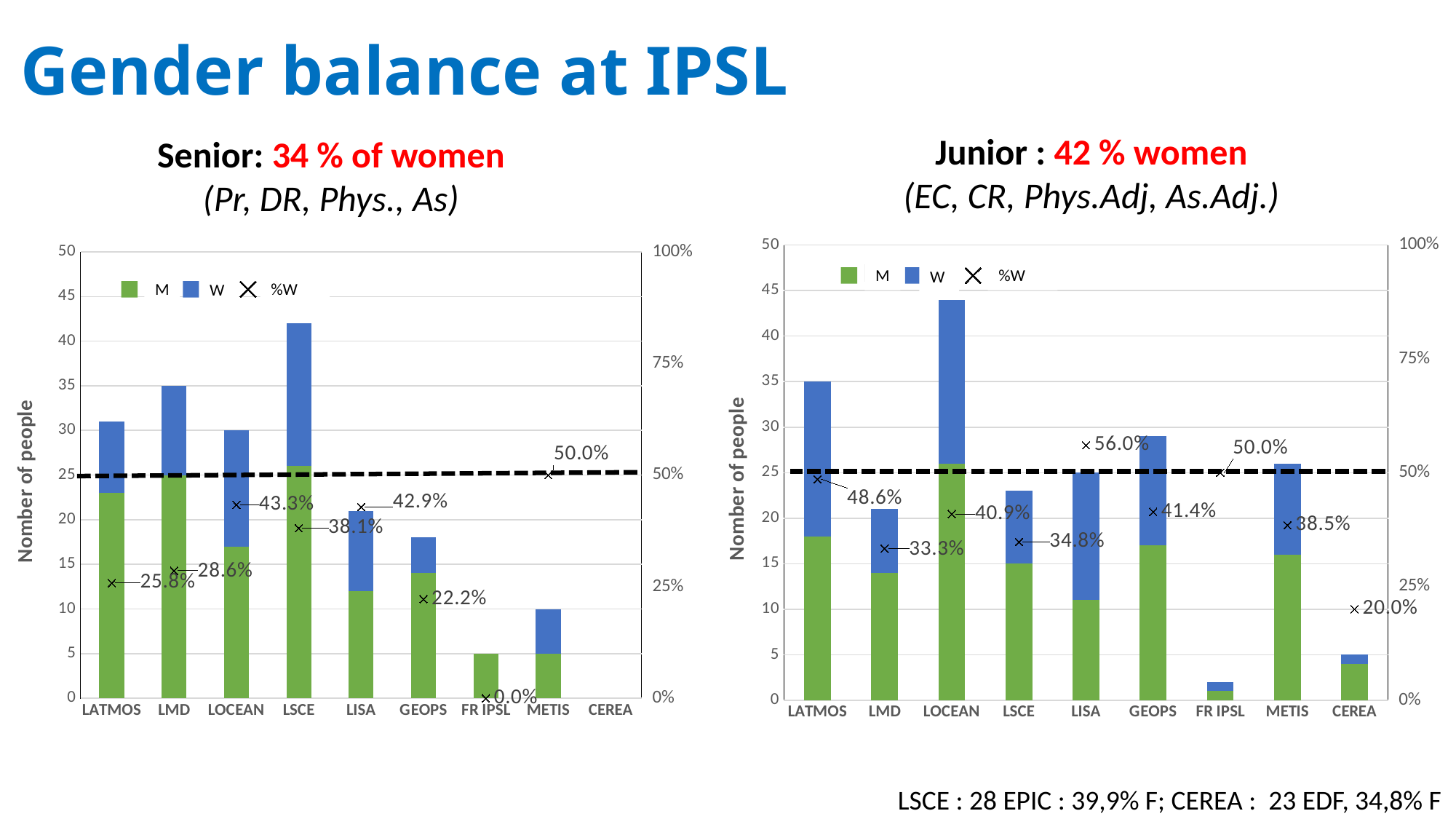
In the Junior chart, which has a higher %W value, LATMOS or LMD? LATMOS In the Junior chart, is the total number of people for LOCEAN greater or less than 40? greater In the Junior chart, what is the %W value for CEREA? 20.0% In the Junior chart, what is the %W value for LISA? 56.0% How many series does the legend of the Senior chart list? 3 In the Senior chart, is the total number of people for LSCE greater or less than 40? greater In the Senior chart, what is the difference between the %W values for METIS and LATMOS? 24.2 percentage points In the Senior chart, what is the %W value for LOCEAN? 43.3% In the Senior chart, what is the %W value for GEOPS? 22.2% In the Senior chart, which laboratory has the lowest %W value? FR IPSL In the Junior chart, which laboratory has the highest %W value? LISA How many laboratories are shown on the x axis of the Junior chart? 9